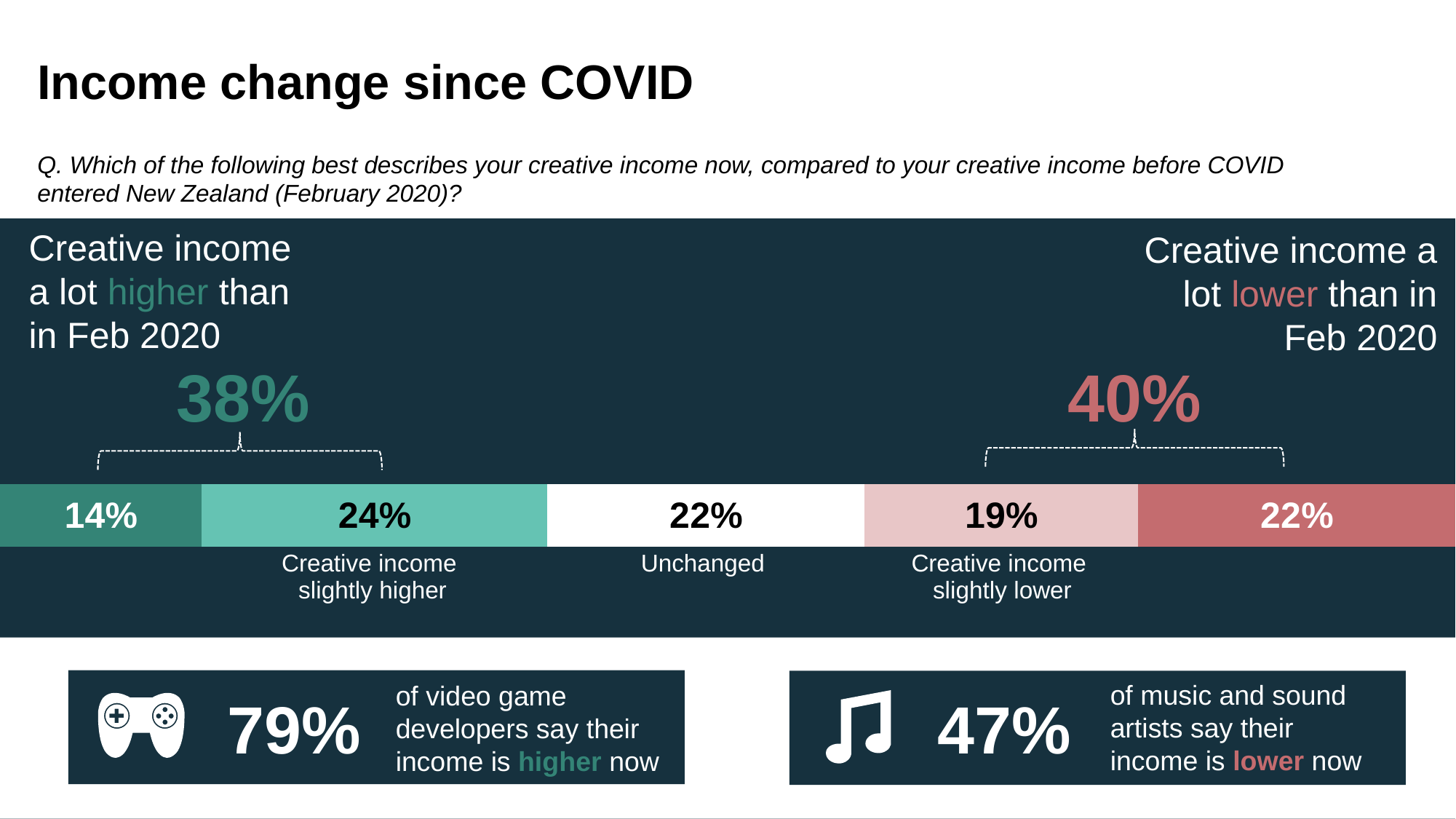
How many response categories are shown in the stacked bar? 5 What kind of chart is used to show the income change responses? Stacked bar chart Which response category has the smallest share in the bar? Creative income a lot higher than in Feb 2020 Which is larger: the share saying income is a lot lower or the share saying income is a lot higher? A lot lower Which response category has the largest share in the bar? Creative income slightly higher What combined percentage of respondents say their creative income is higher (a lot or slightly) than in Feb 2020? 38% What percentage of respondents say their creative income is unchanged? 22% What percentage of respondents say their creative income is slightly lower? 19% What percentage of respondents say their creative income is slightly higher? 24% What is the difference between the share saying income is slightly higher and the share saying income is slightly lower? 5% What percentage of respondents say their creative income is a lot higher than in Feb 2020? 14% What combined percentage of respondents say their creative income is lower (a lot or slightly) than in Feb 2020? 40%